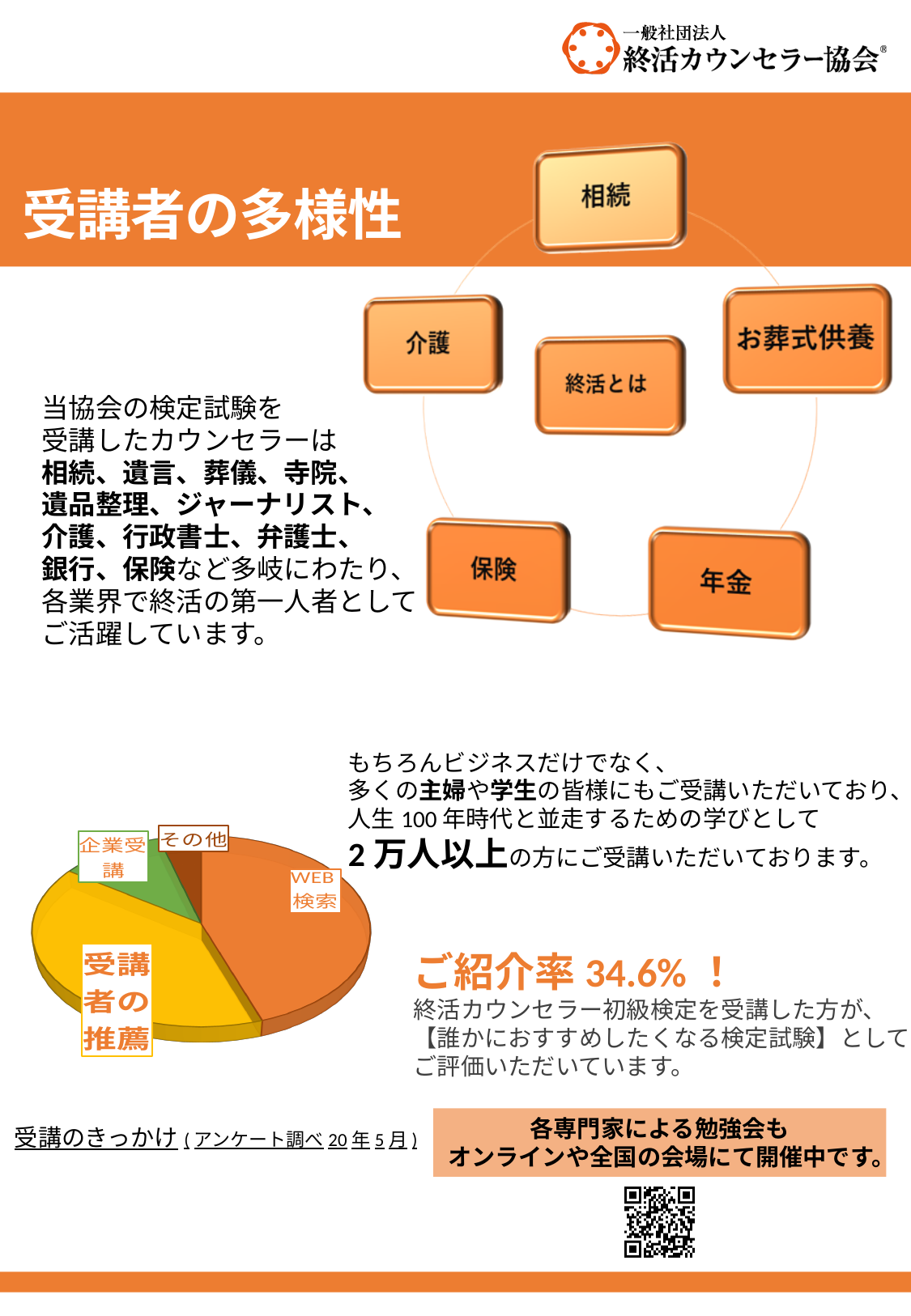
In the pie chart, which slice is larger: 企業受講 or その他? 企業受講 How many slices does the pie chart have? 4 Which category has the largest slice in the pie chart? WEB検索 What is the title given for the pie chart? 受講のきっかけ In the pie chart, which slice is larger: 受講者の推薦 or 企業受講? 受講者の推薦 In the pie chart, which slice is larger: WEB検索 or 受講者の推薦? WEB検索 Which category has the smallest slice in the pie chart? その他 What kind of chart is shown at the bottom left of the slide? pie chart What colour is the 受講者の推薦 slice in the pie chart? yellow